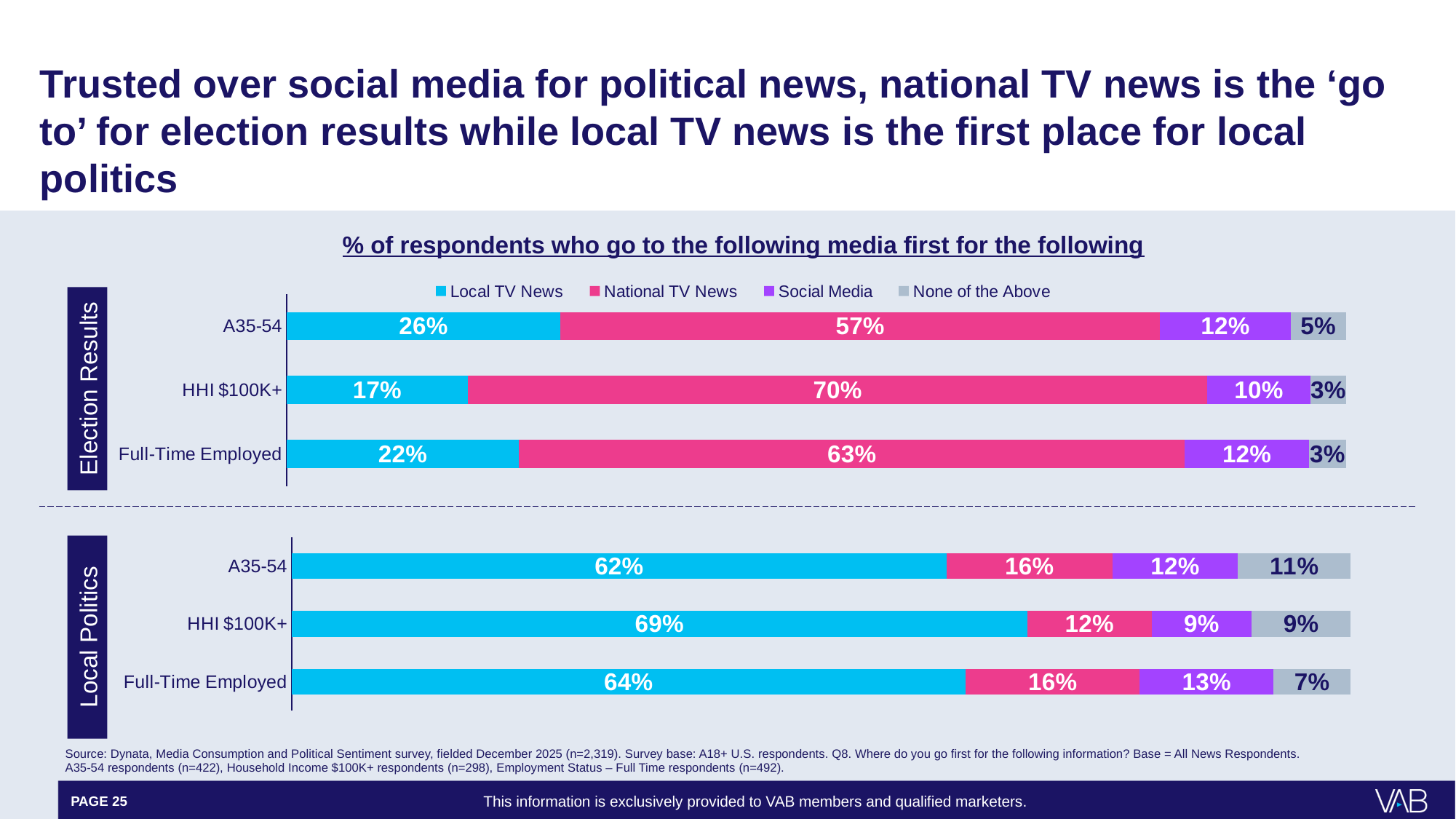
In the Local Politics chart, what percentage of A35-54 respondents go to Local TV News first? 62% In the Local Politics chart, what is the None of the Above value for Full-Time Employed respondents? 7% In the Election Results chart, what is the total of the A35-54 bar? 100% In the Election Results chart, what percentage of HHI $100K+ respondents go to National TV News first? 70% How many series does the legend list? 4 What kind of chart is used on this slide? Stacked bar chart How many respondent groups are shown in the Local Politics chart? 3 In the Election Results chart, what is the difference between the National TV News values for HHI $100K+ and A35-54? 13 percentage points In the Election Results chart, which group has the highest National TV News value? HHI $100K+ In the Election Results chart, what is the Social Media value for Full-Time Employed respondents? 12% In the Local Politics chart, which is larger for HHI $100K+: the Local TV News value or the National TV News value? Local TV News In the Local Politics chart, which group has the lowest Local TV News value? A35-54